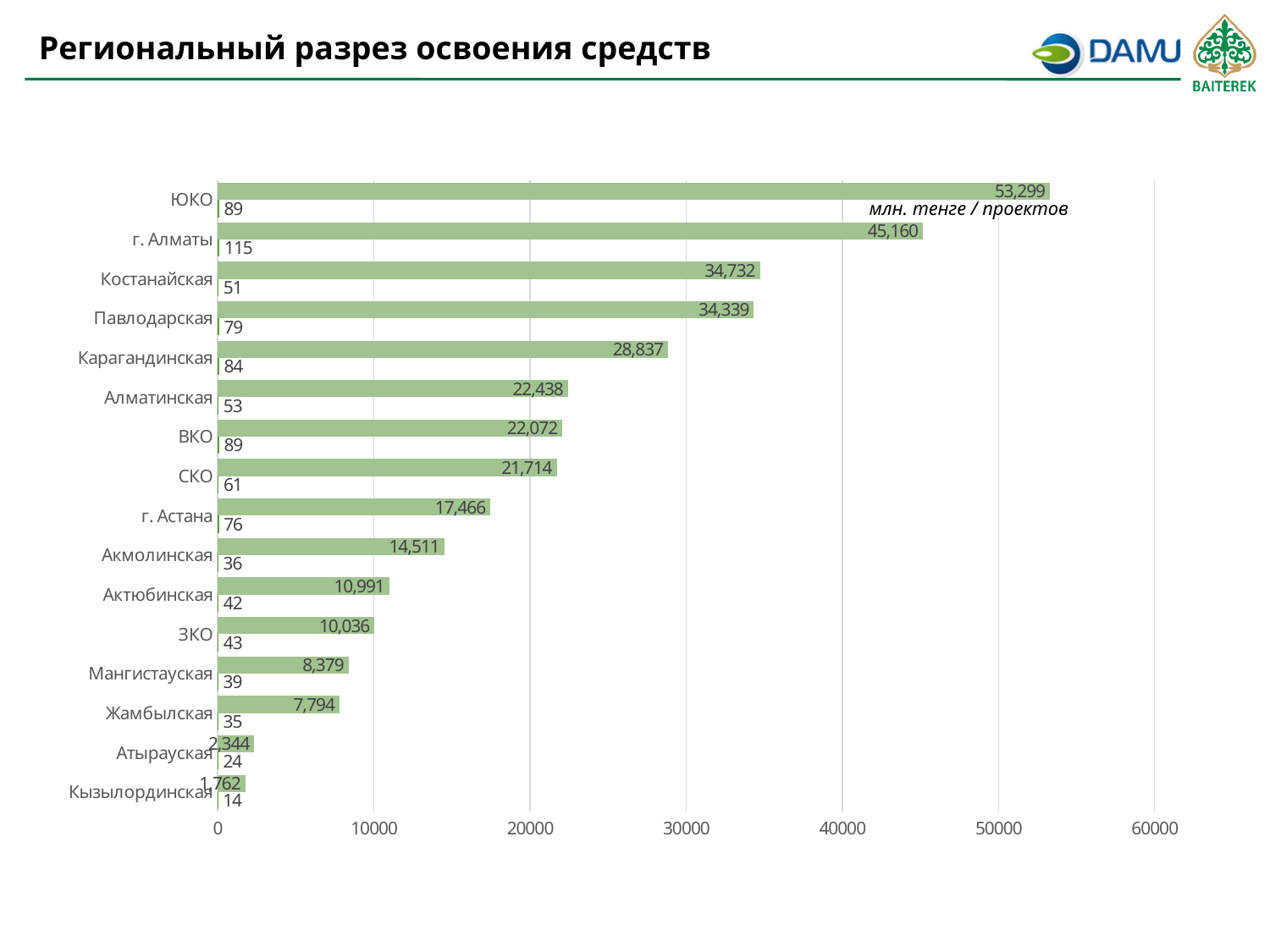
How many projects (проектов) are shown for г. Алматы? 115 What is the value in млн. тенге for ЮКО? 53,299 What kind of chart is shown on the slide? bar chart What is the difference in млн. тенге between ЮКО and г. Алматы? 8,139 Which region has the lowest value in млн. тенге? Кызылординская What is the value in млн. тенге for Карагандинская? 28,837 How many projects (проектов) are shown for Кызылординская? 14 How many regions are shown on the chart? 16 What is the title of the slide? Региональный разрез освоения средств Which region has the highest value in млн. тенге? ЮКО Which has a larger value in млн. тенге, Костанайская or Павлодарская? Костанайская Is the value in млн. тенге for г. Астана greater or less than 20000? less